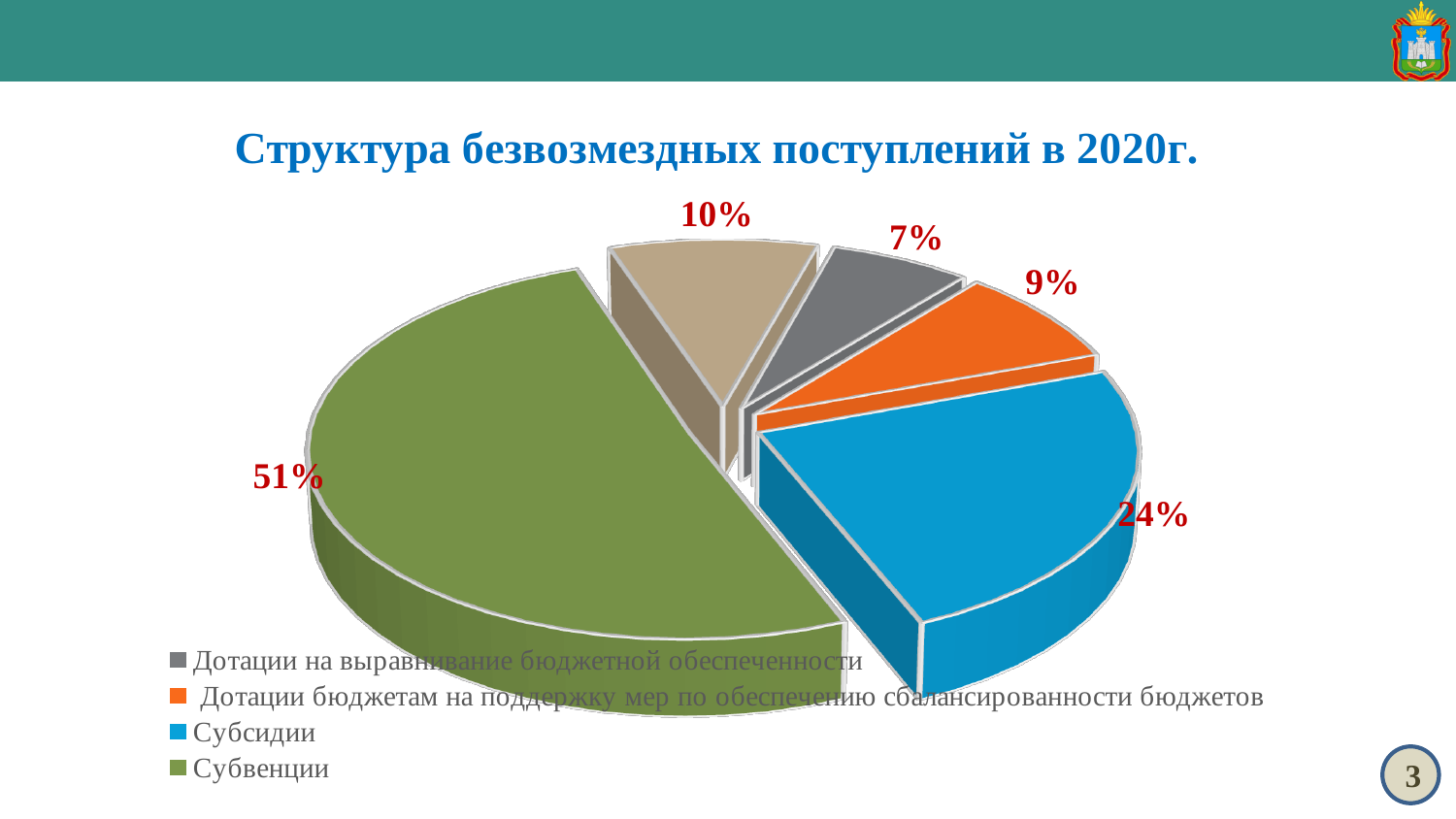
What is the title of the chart? Структура безвозмездных поступлений в 2020г. How many slices does the pie chart have? 5 What kind of chart is shown on the slide? pie chart What is the value for Дотации бюджетам на поддержку мер по обеспечению сбалансированности бюджетов? 9% Which is larger: the share of Субсидии or the share of Дотации бюджетам на поддержку мер по обеспечению сбалансированности бюджетов? Субсидии What share of the pie does Субвенции have? 51% Which category has the largest slice of the pie? Субвенции What is the value for Дотации на выравнивание бюджетной обеспеченности? 7% Which category has the smallest slice of the pie? Дотации на выравнивание бюджетной обеспеченности How many entries does the legend list? 4 What is the difference between the shares of Субвенции and Субсидии? 27% What share of the pie does Субсидии have? 24%